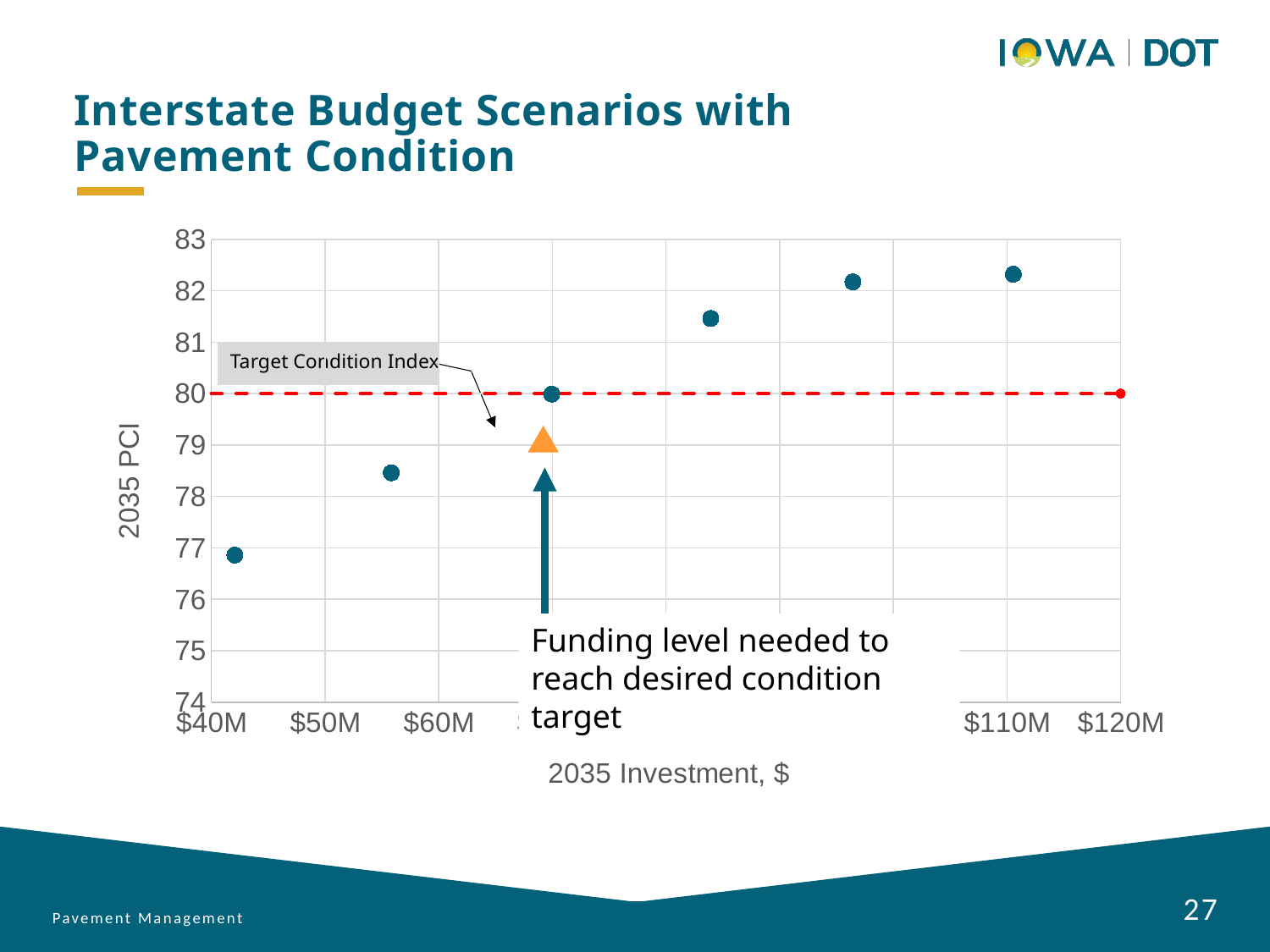
What is the label of the y axis? 2035 PCI Is the 2035 PCI for the point near $110M greater or less than 82? greater Is the 2035 PCI for the leftmost point (just above $40M) greater or less than 77? less Which has the higher 2035 PCI, the point just below $60M or the point near $110M? the point near $110M Is the 2035 PCI for the point near $110M greater or less than the Target Condition Index of 80? greater Do the 2035 PCI values rise or fall as 2035 Investment increases along the x axis? rise What kind of chart is shown on the slide? scatter chart How many plotted data points (blue dots) are shown in the chart? 6 Which plotted point has the lowest 2035 PCI, the leftmost one near $40M or the rightmost one near $110M? the leftmost one near $40M What value does the dashed red Target Condition Index line sit at on the y axis? 80 What is the title of the slide's chart? Interstate Budget Scenarios with Pavement Condition